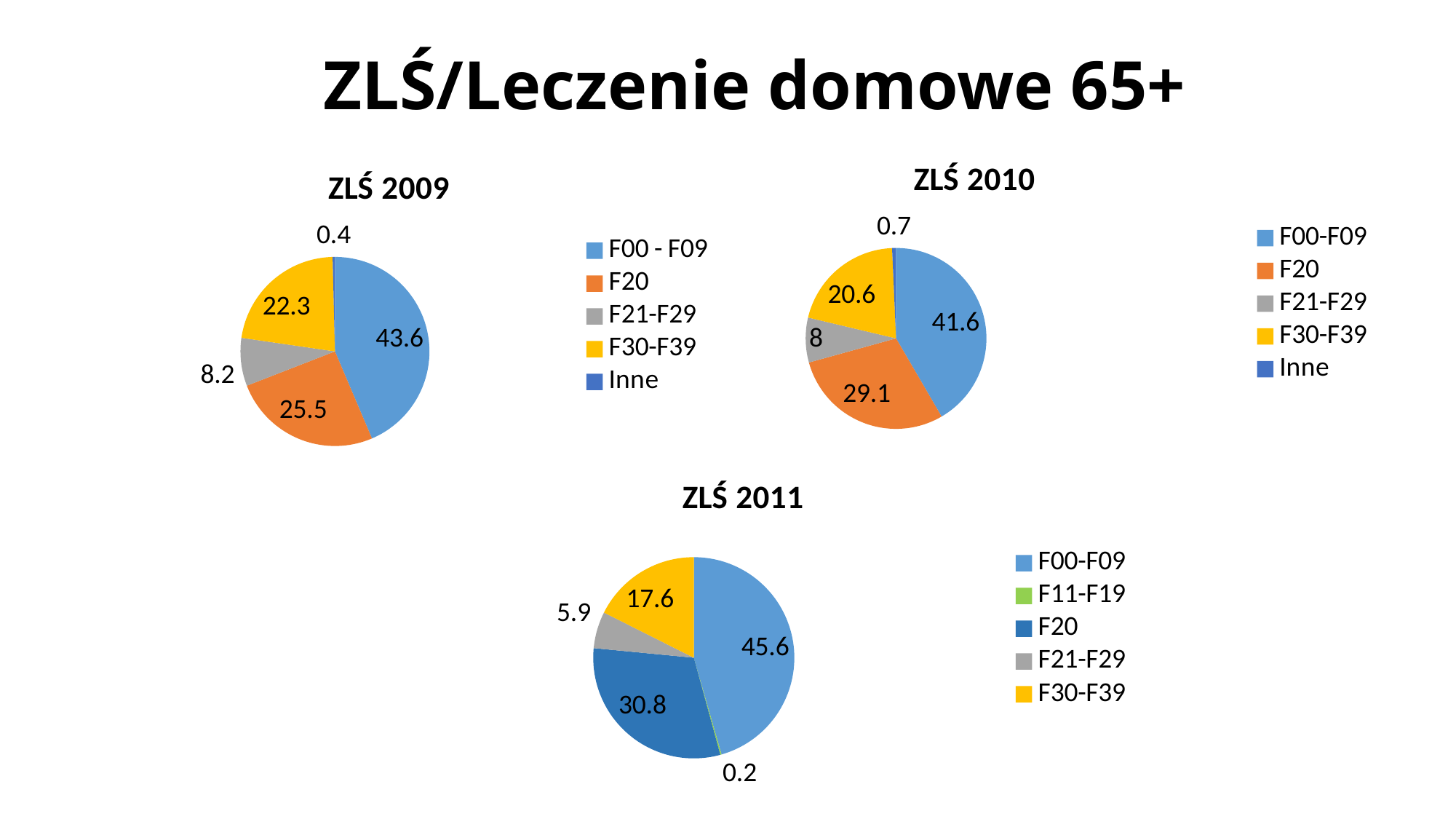
In the ZLŚ 2011 chart, what is the difference between the values for F00-F09 and F20? 14.8 What type of chart is ZLŚ 2011? Pie chart In the ZLŚ 2009 chart, what is the value for F20? 25.5 In the ZLŚ 2009 chart, which category has the largest slice? F00 - F09 In the ZLŚ 2010 chart, which category has the smallest slice? Inne In the ZLŚ 2011 chart, what is the value for F21-F29? 5.9 In the ZLŚ 2010 chart, which is larger, the value for F20 or the value for F30-F39? F20 How many slices does the ZLŚ 2009 chart have? 5 In the ZLŚ 2011 chart, which category has the smallest slice? F11-F19 In the ZLŚ 2009 chart, what is the difference between the values for F30-F39 and F21-F29? 14.1 Which legend entry appears in the ZLŚ 2011 chart but not in the ZLŚ 2009 or ZLŚ 2010 charts? F11-F19 In the ZLŚ 2010 chart, what is the value for F30-F39? 20.6